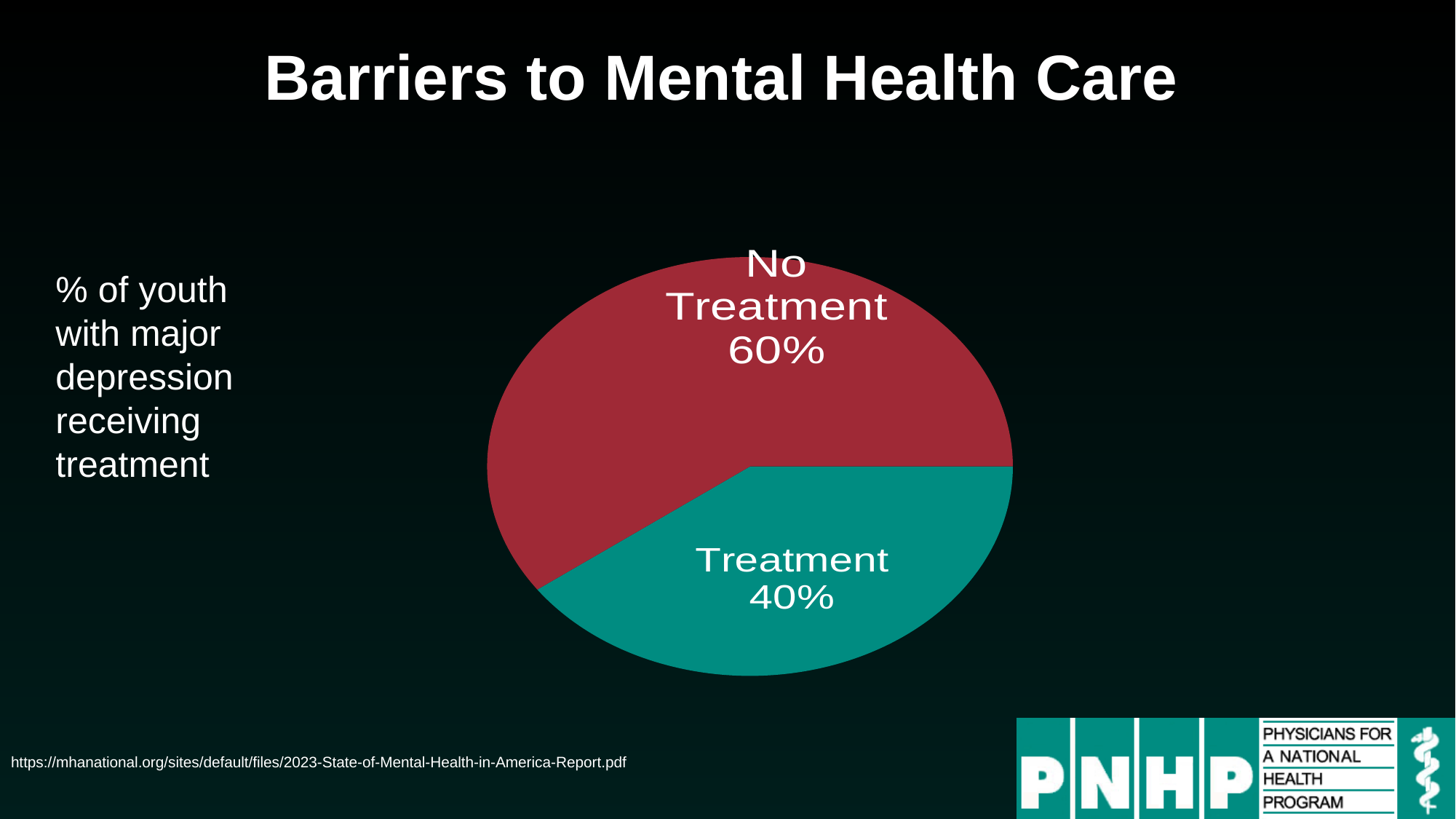
Which is larger, the "Treatment" slice or the "No Treatment" slice? No Treatment Which slice of the pie is the largest? No Treatment What colour is the "No Treatment" slice? red What colour is the "Treatment" slice? teal What percentage of the pie is labelled "Treatment"? 40% What is the difference in percentage points between the "No Treatment" and "Treatment" slices? 20 How many slices does the pie chart have? 2 What percentage of the pie is labelled "No Treatment"? 60% What kind of chart is shown on the slide? pie chart What share of the pie does the "Treatment" slice represent? 40% Which slice of the pie is the smallest? Treatment